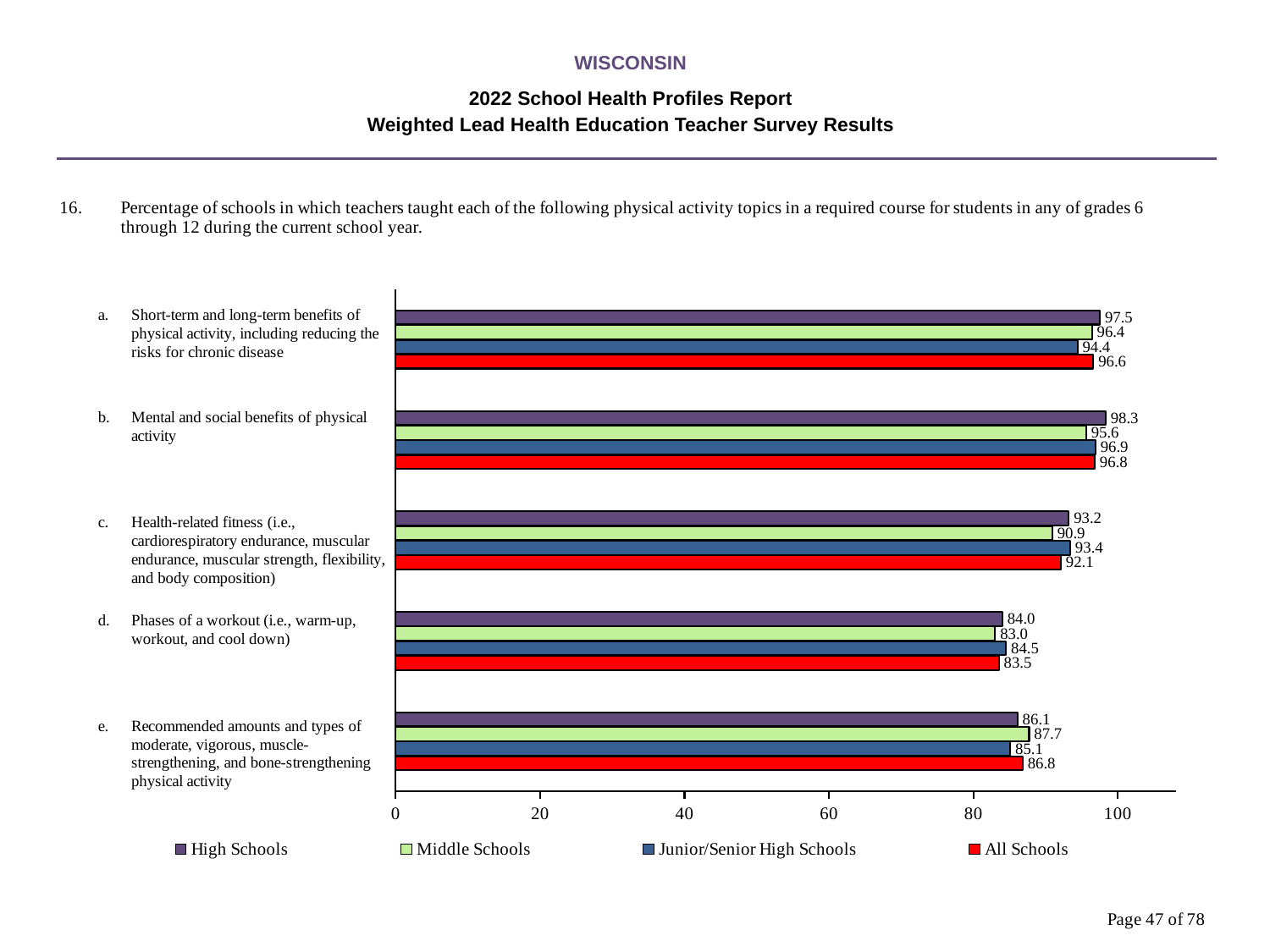
What colour represents All Schools in the chart? Red What is the value for All Schools for topic d, phases of a workout? 83.5 What is the difference between the High Schools and Middle Schools values for topic a, short-term and long-term benefits of physical activity? 1.1 What is the value for Junior/Senior High Schools for topic c, health-related fitness? 93.4 Which topic has the highest value for High Schools? b. Mental and social benefits of physical activity What kind of chart is shown on the slide? Bar chart How many physical activity topics are shown on the chart? 5 For topic e, which is larger: the Middle Schools value or the Junior/Senior High Schools value? Middle Schools What is the value for High Schools for topic b, mental and social benefits of physical activity? 98.3 Which topic has the lowest value for All Schools? d. Phases of a workout What is the value for Middle Schools for topic e, recommended amounts and types of physical activity? 87.7 How many series does the legend list? 4